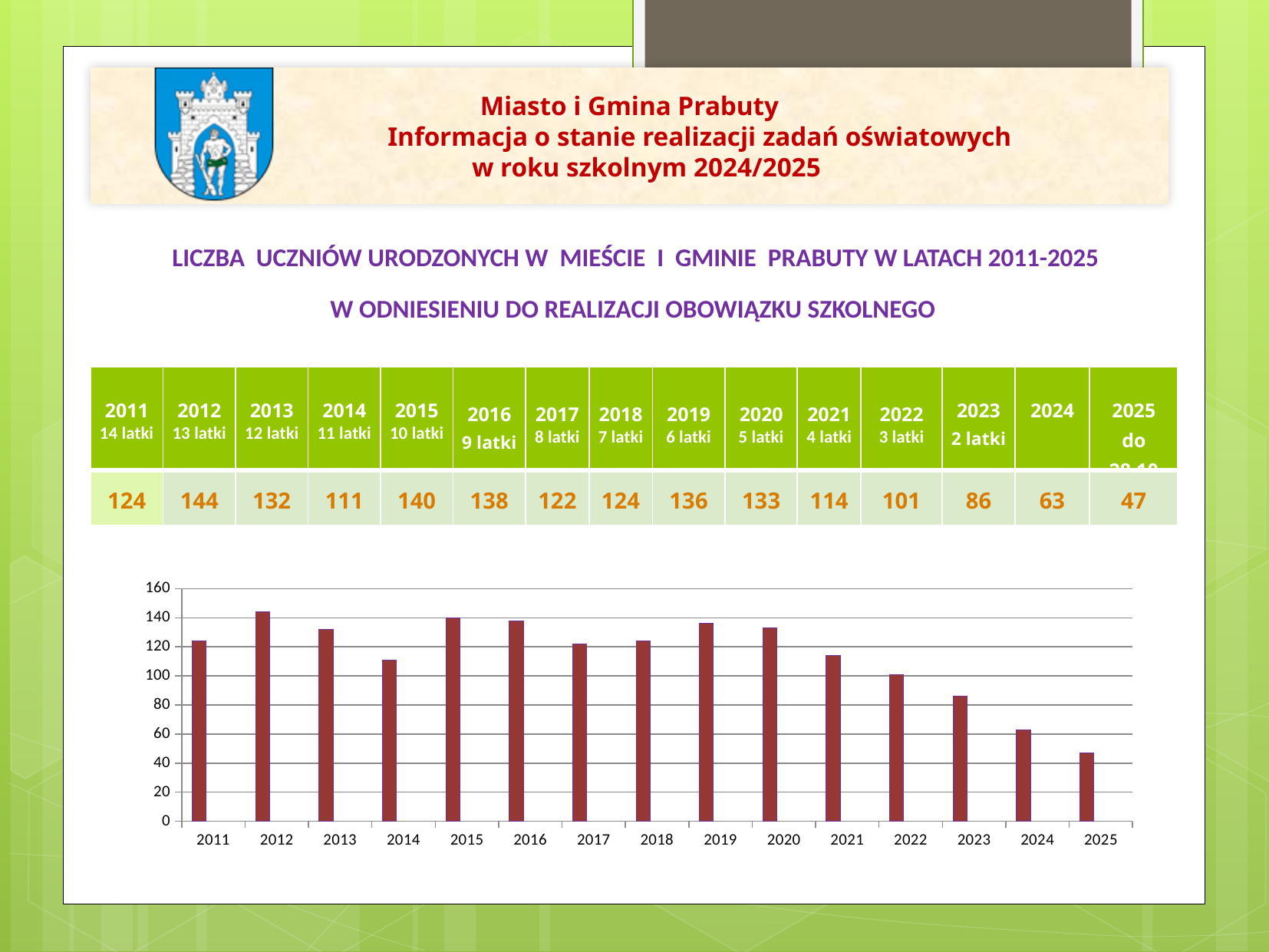
Do the values rise or fall from 2020 to 2025 along the x axis? fall Which is larger, the value for 2014 or the value for 2019? 2019 What is the value for 2015 in the chart? 140 What is the value for 2012 in the chart? 144 Which year has the highest bar in the chart? 2012 What is the value for 2025 in the chart? 47 What is the difference between the values for 2023 and 2024? 23 Is the value for 2021 greater or less than 100? greater What kind of chart is shown at the bottom of the slide? bar chart What is the difference between the values for 2012 and 2025? 97 How many years (categories) are shown on the x axis of the bar chart? 15 Which year has the lowest bar in the chart? 2025